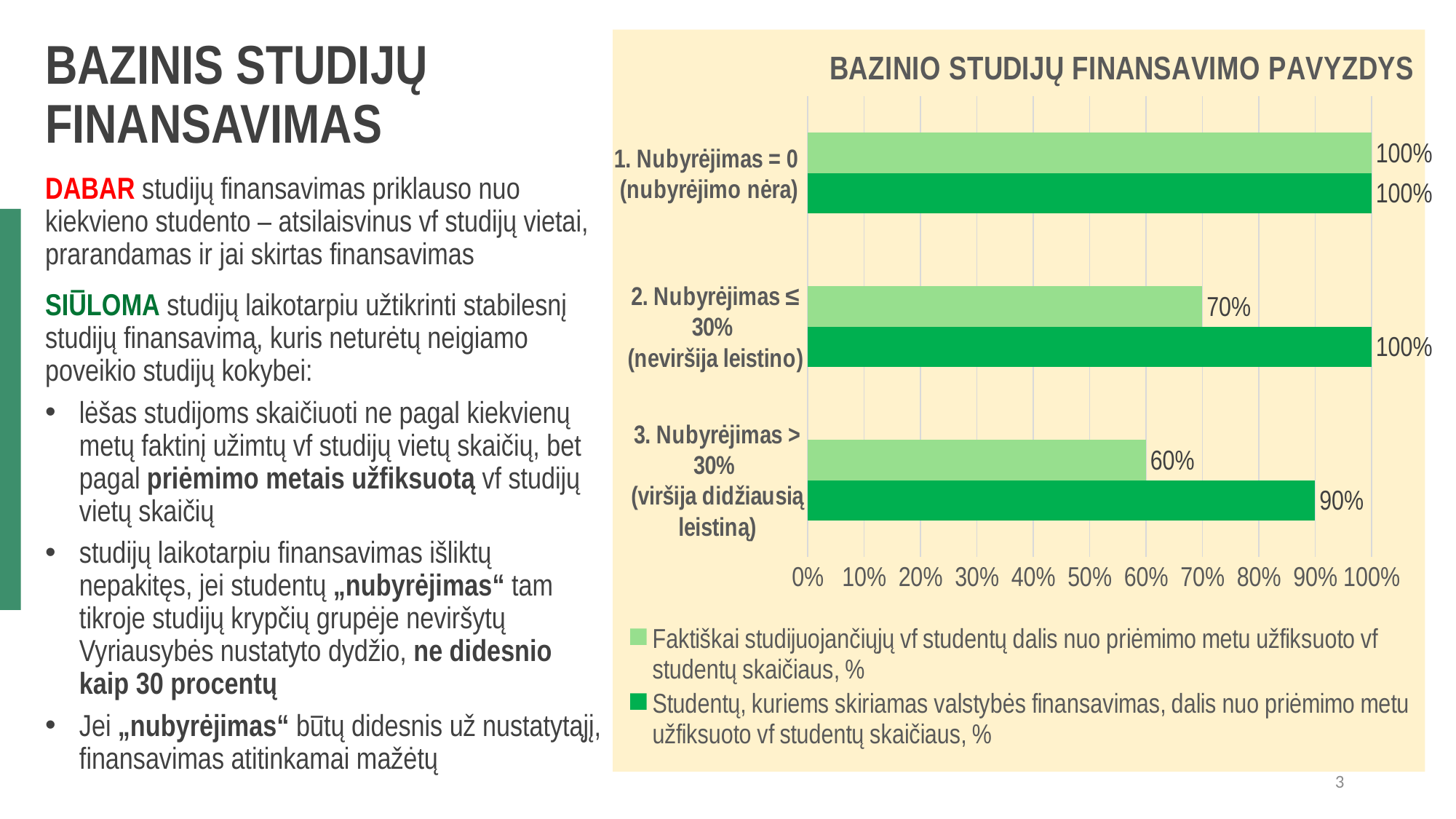
What is the difference between the dark green and light green bars for category '3. Nubyrėjimas > 30%'? 30% Which category has the lowest value for the light green series (Faktiškai studijuojančiųjų vf studentų dalis)? 3. Nubyrėjimas > 30% What is the title of the chart? BAZINIO STUDIJŲ FINANSAVIMO PAVYZDYS What is the difference between the dark green and light green bars for category '2. Nubyrėjimas ≤ 30%'? 30% How many categories are shown on the chart? 3 What is the value of the light green bar for category '3. Nubyrėjimas > 30%'? 60% What is the value of the dark green bar for category '2. Nubyrėjimas ≤ 30%'? 100% What type of chart is shown on the slide? bar chart Which is larger for category '3. Nubyrėjimas > 30%': the light green bar or the dark green bar? the dark green bar What is the value of the dark green bar (Studentų, kuriems skiriamas valstybės finansavimas, dalis) for category '3. Nubyrėjimas > 30%'? 90% What is the value of the light green bar (Faktiškai studijuojančiųjų vf studentų dalis) for category '2. Nubyrėjimas ≤ 30%'? 70% How many series does the chart legend list? 2